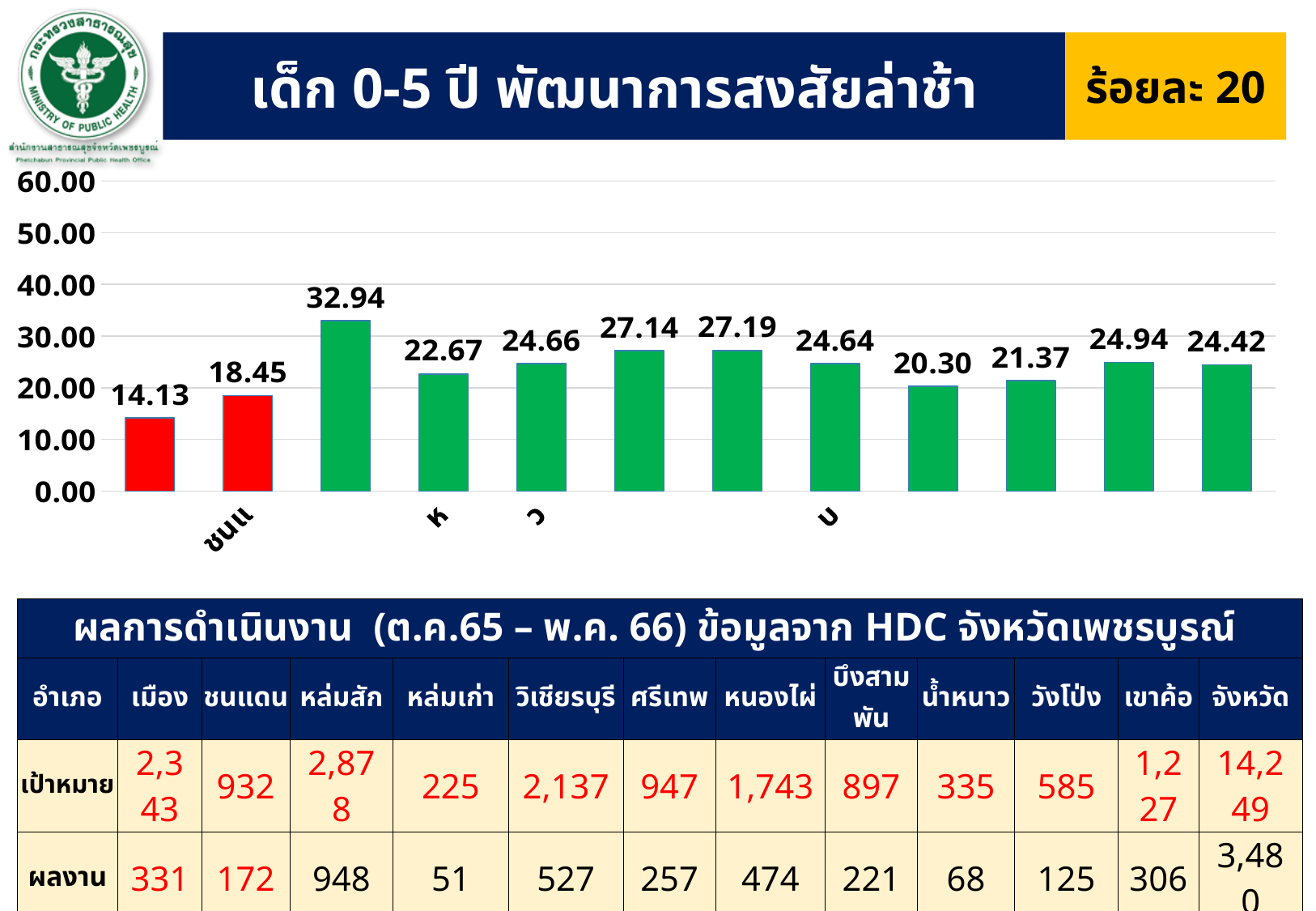
What is the difference between the highest bar (32.94) and the lowest bar (14.13)? 18.81 What is the value of the last (rightmost) bar in the chart? 24.42 Which is larger: the second bar from the left (18.45) or the fourth bar from the left (22.67)? the fourth bar (22.67) What is the value of the first (leftmost) bar in the chart? 14.13 Is the value of the third bar from the left greater or less than 30? greater What is the lowest value shown in the chart? 14.13 What is the title of the chart? เด็ก 0-5 ปี พัฒนาการสงสัยล่าช้า What is the value of the second bar from the left in the chart? 18.45 How many bars are plotted in the chart? 12 What is the highest value shown in the chart? 32.94 What kind of chart is shown on the slide? bar chart How many bars in the chart are coloured red? 2